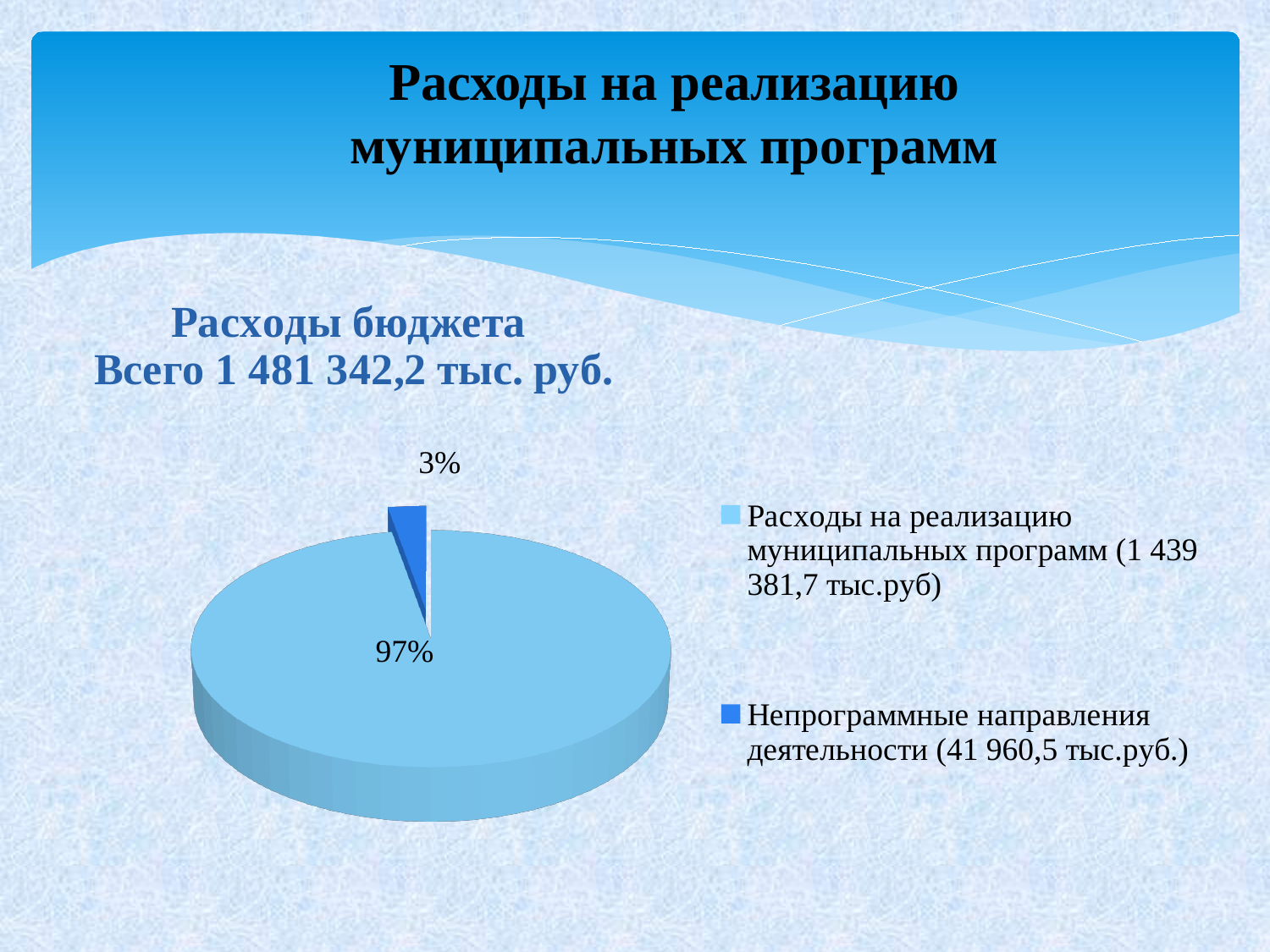
Which category has the smallest slice of the pie? Непрограммные направления деятельности What total budget expenditure is stated above the pie chart? 1 481 342,2 тыс. руб. What is the difference in percentage points between the 97% slice and the 3% slice? 94 percentage points What kind of chart is shown on the slide? pie chart Which category has the largest slice of the pie? Расходы на реализацию муниципальных программ What share of the pie is labelled for "Непрограммные направления деятельности"? 3% What share of the pie is labelled for "Расходы на реализацию муниципальных программ"? 97% How many slices does the pie chart have? 2 What amount is given in the legend for "Расходы на реализацию муниципальных программ"? 1 439 381,7 тыс.руб How many entries does the legend of the pie chart list? 2 What amount is given in the legend for "Непрограммные направления деятельности"? 41 960,5 тыс.руб. Which is larger: the share for "Расходы на реализацию муниципальных программ" or the share for "Непрограммные направления деятельности"? Расходы на реализацию муниципальных программ